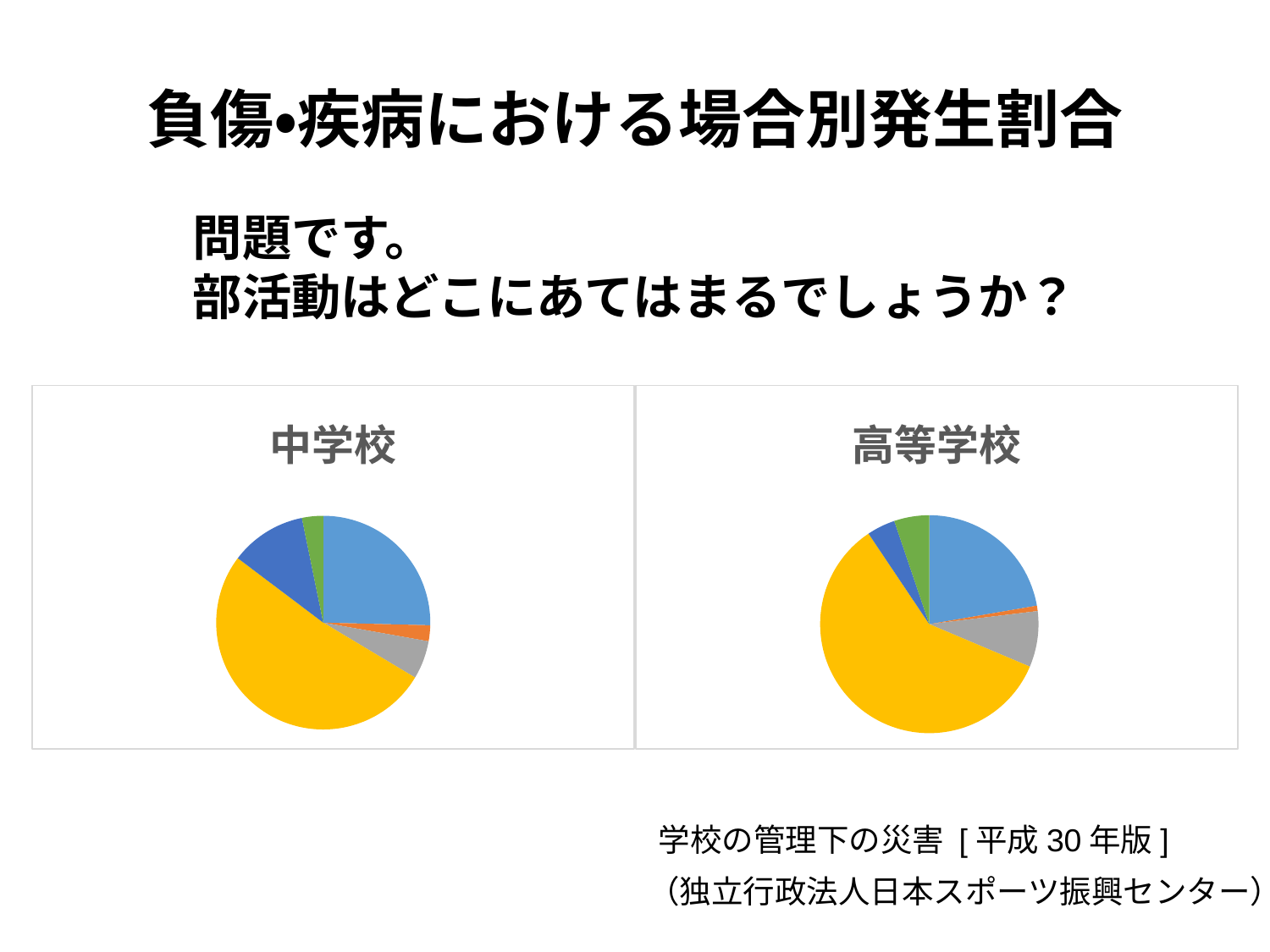
How many slices does the 高等学校 pie chart have? 6 How many slices does the 中学校 pie chart have? 6 What is the title of the left pie chart? 中学校 What is the title of the right pie chart? 高等学校 In the 高等学校 pie chart, is the yellow slice larger or smaller than the light blue slice? larger What kind of chart is the 高等学校 chart? pie chart In the 中学校 pie chart, which colour slice is the smallest? orange In the 高等学校 pie chart, which colour slice is the largest? yellow What kind of chart is the 中学校 chart? pie chart In the 中学校 pie chart, which colour slice is the largest? yellow In the 高等学校 pie chart, which colour slice is the smallest? orange